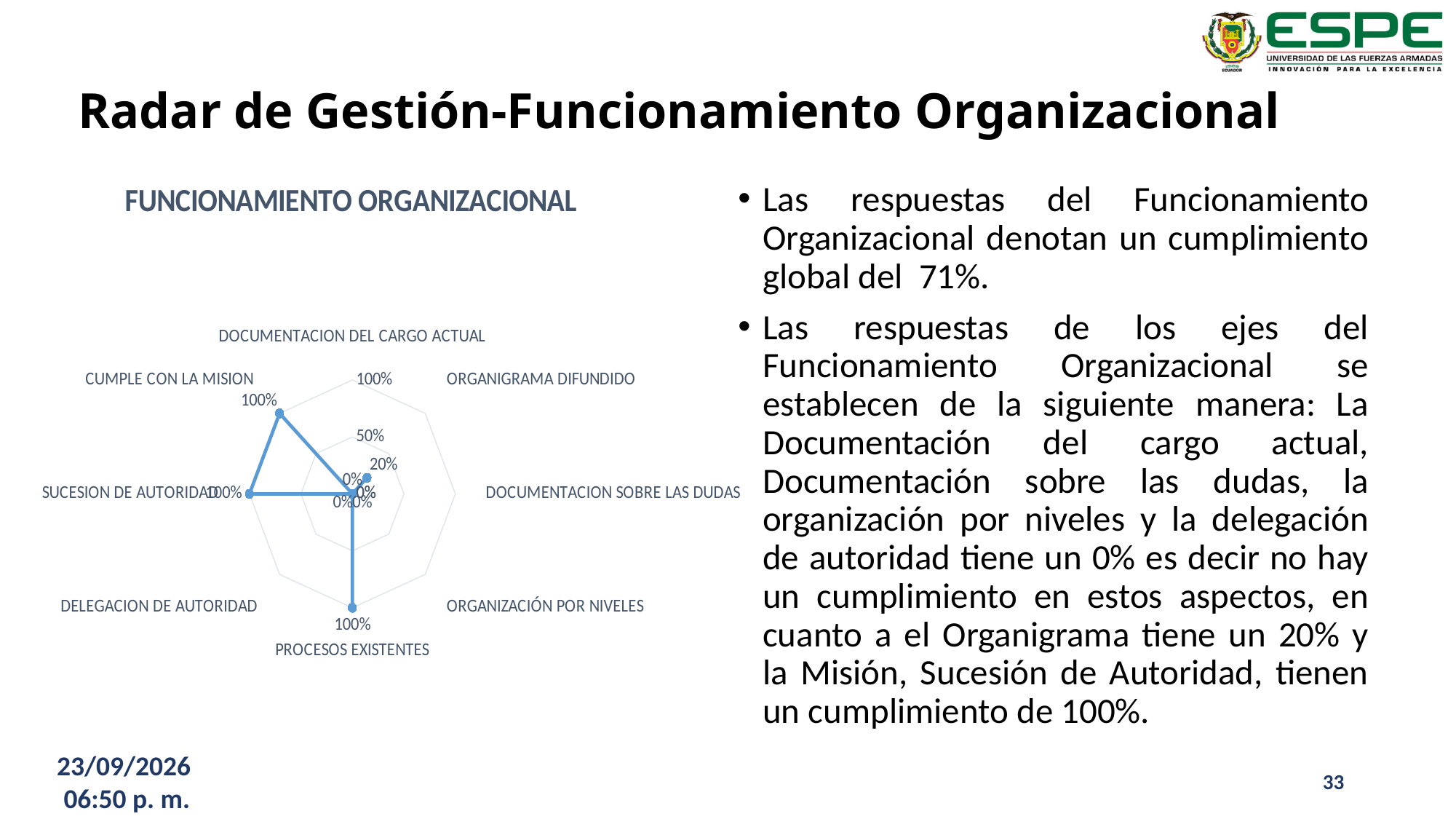
How many categories (axes) does the radar chart have? 8 What kind of chart is shown under the title FUNCIONAMIENTO ORGANIZACIONAL? Radar chart What is the title of the radar chart? FUNCIONAMIENTO ORGANIZACIONAL What is the difference between the values for CUMPLE CON LA MISION and ORGANIGRAMA DIFUNDIDO in the radar chart? 80% What is the value for SUCESION DE AUTORIDAD in the radar chart? 100% What is the value for DELEGACION DE AUTORIDAD in the radar chart? 0% What is the value for ORGANIGRAMA DIFUNDIDO in the radar chart? 20% Is the value for ORGANIGRAMA DIFUNDIDO in the radar chart greater or less than 50%? less What is the value for CUMPLE CON LA MISION in the radar chart? 100% What is the value for ORGANIZACIÓN POR NIVELES in the radar chart? 0% What is the value for PROCESOS EXISTENTES in the radar chart? 100% Which is larger in the radar chart, ORGANIGRAMA DIFUNDIDO or PROCESOS EXISTENTES? PROCESOS EXISTENTES